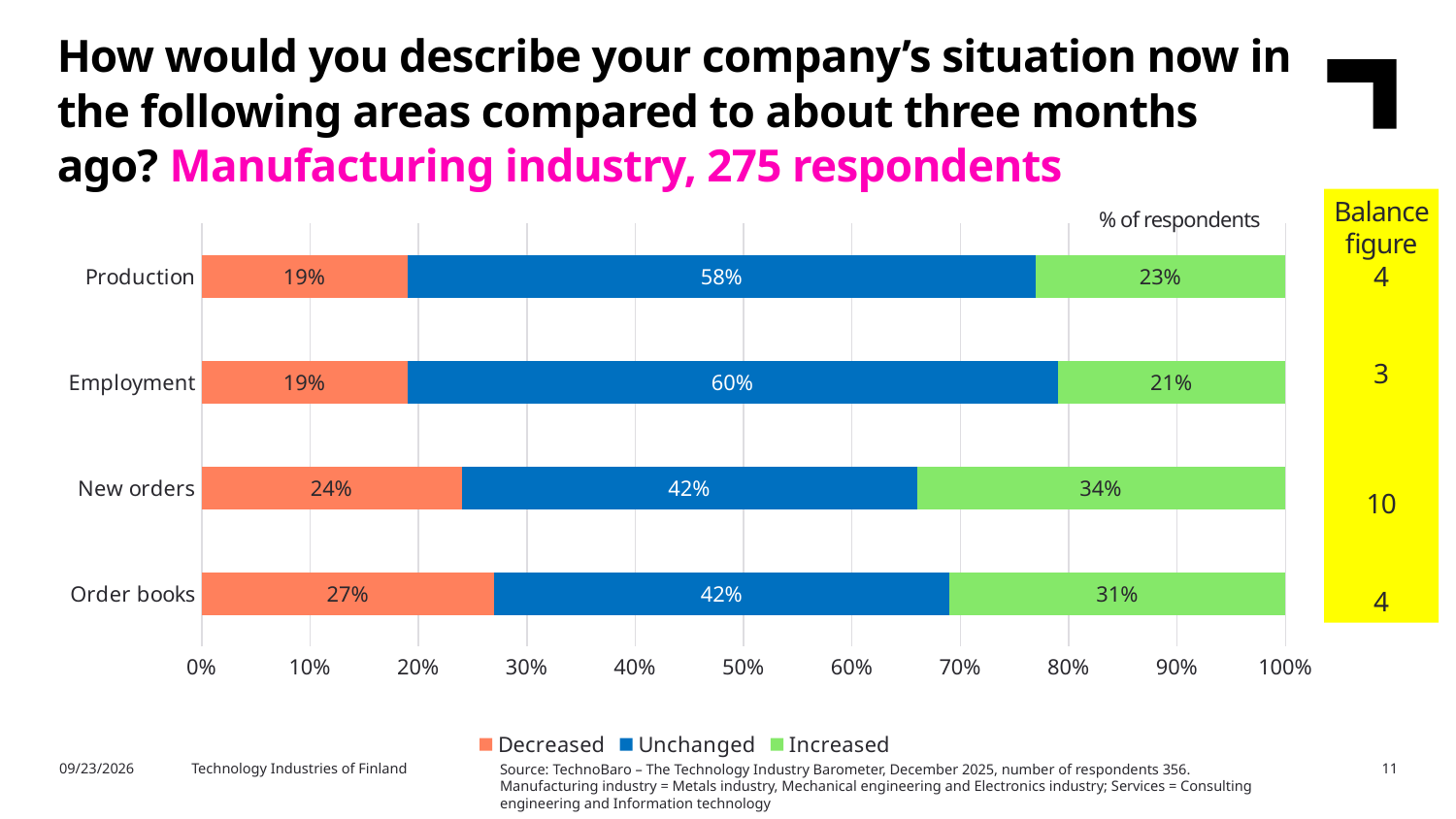
How many categories are shown on the chart? 4 What is the total of the stacked bar for Employment? 100% What percentage of respondents reported that Production was unchanged? 58% Which colour represents the 'Unchanged' series in the chart? Blue What percentage of respondents reported that Order books decreased? 27% Which category has the highest share of respondents reporting 'Increased'? New orders Which is larger: the 'Decreased' share for Order books or the 'Decreased' share for New orders? Order books What percentage of respondents reported that New orders increased? 34% How many series does the legend list? 3 What kind of chart is shown on the slide? Stacked bar chart Which category has the lowest share of respondents reporting 'Decreased'? Production and Employment (19% each) What is the difference between the 'Increased' share for New orders and the 'Increased' share for Employment? 13 percentage points